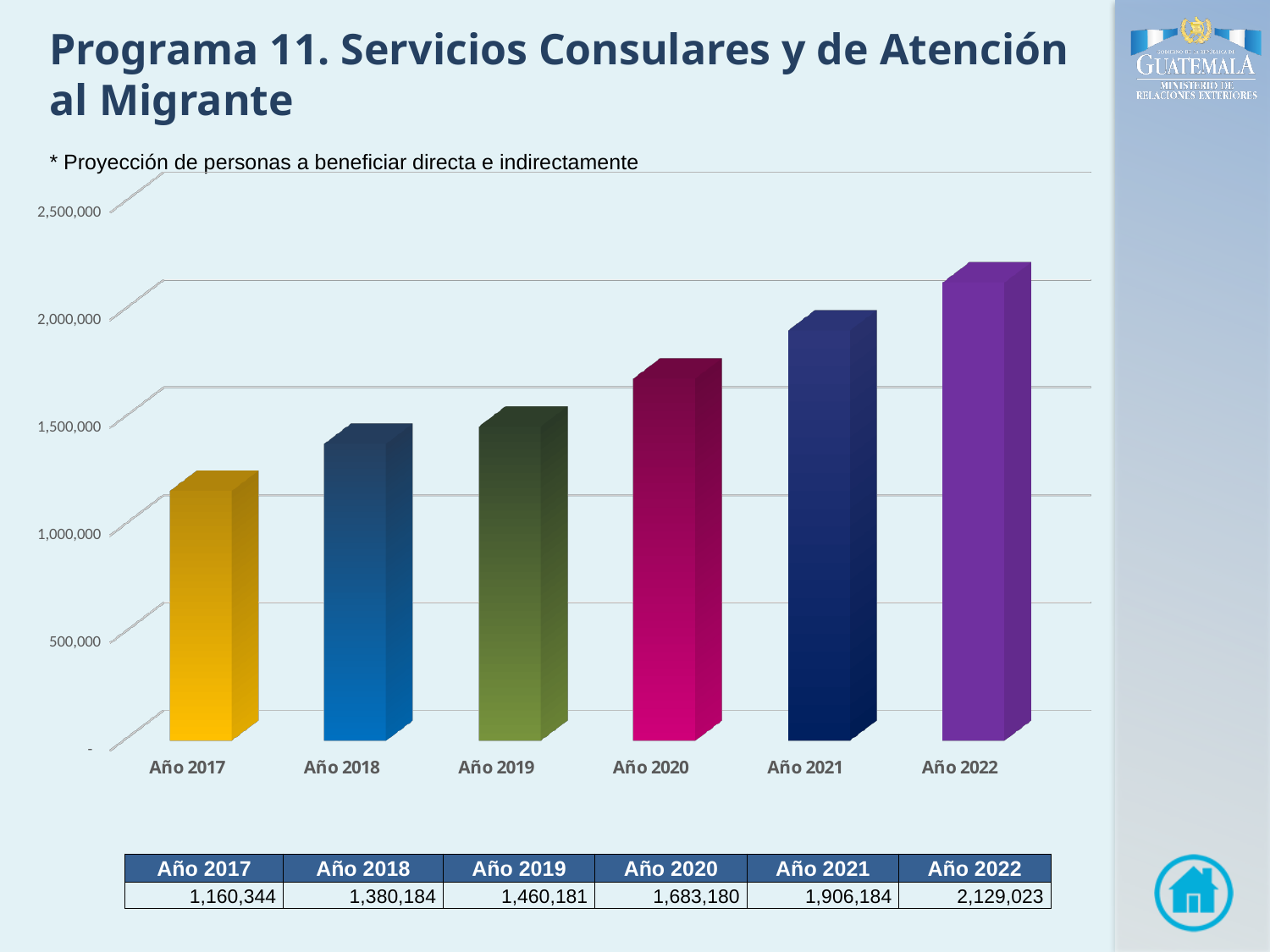
What is the projected number of people to benefit in Año 2017? 1,160,344 Is the value for Año 2022 greater or less than 2,000,000? greater Which year has the highest projected value? Año 2022 How many years are shown on the chart? 6 What kind of chart is shown on the slide? Bar chart Which is larger, the value for Año 2019 or the value for Año 2021? Año 2021 What is the difference between the values for Año 2022 and Año 2017? 968,679 Do the values rise or fall from Año 2017 to Año 2022? Rise What is the value shown for Año 2020? 1,683,180 Which year has the lowest projected value? Año 2017 What is the difference between the values for Año 2021 and Año 2020? 223,004 What is the value shown for Año 2022? 2,129,023